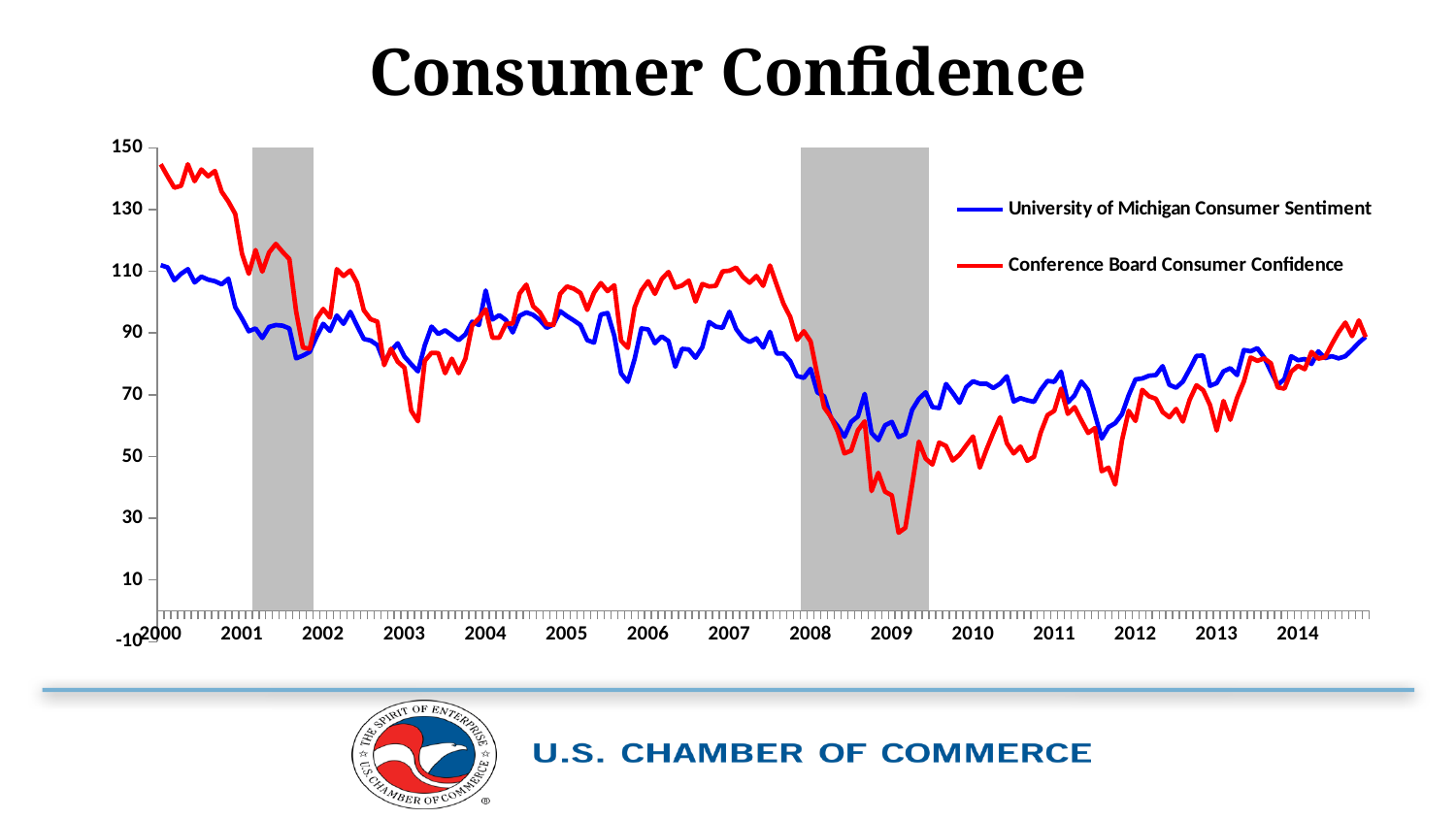
Which series is drawn in red? Conference Board Consumer Confidence How many series does the legend list? 2 Is the Conference Board Consumer Confidence value at the start of 2000 greater or less than 130? greater Is the University of Michigan Consumer Sentiment value at the start of 2000 greater or less than 100? greater What is the title of the chart? Consumer Confidence At the start of 2000, which series has the higher value, University of Michigan Consumer Sentiment or Conference Board Consumer Confidence? Conference Board Consumer Confidence How many year labels are shown on the x axis? 15 In early 2009, which series reaches the lower value, University of Michigan Consumer Sentiment or Conference Board Consumer Confidence? Conference Board Consumer Confidence Is the lowest University of Michigan Consumer Sentiment value in 2009 greater or less than 70? less Does the Conference Board Consumer Confidence series rise or fall from 2000 to 2001? fall What kind of chart is shown on the slide? line chart